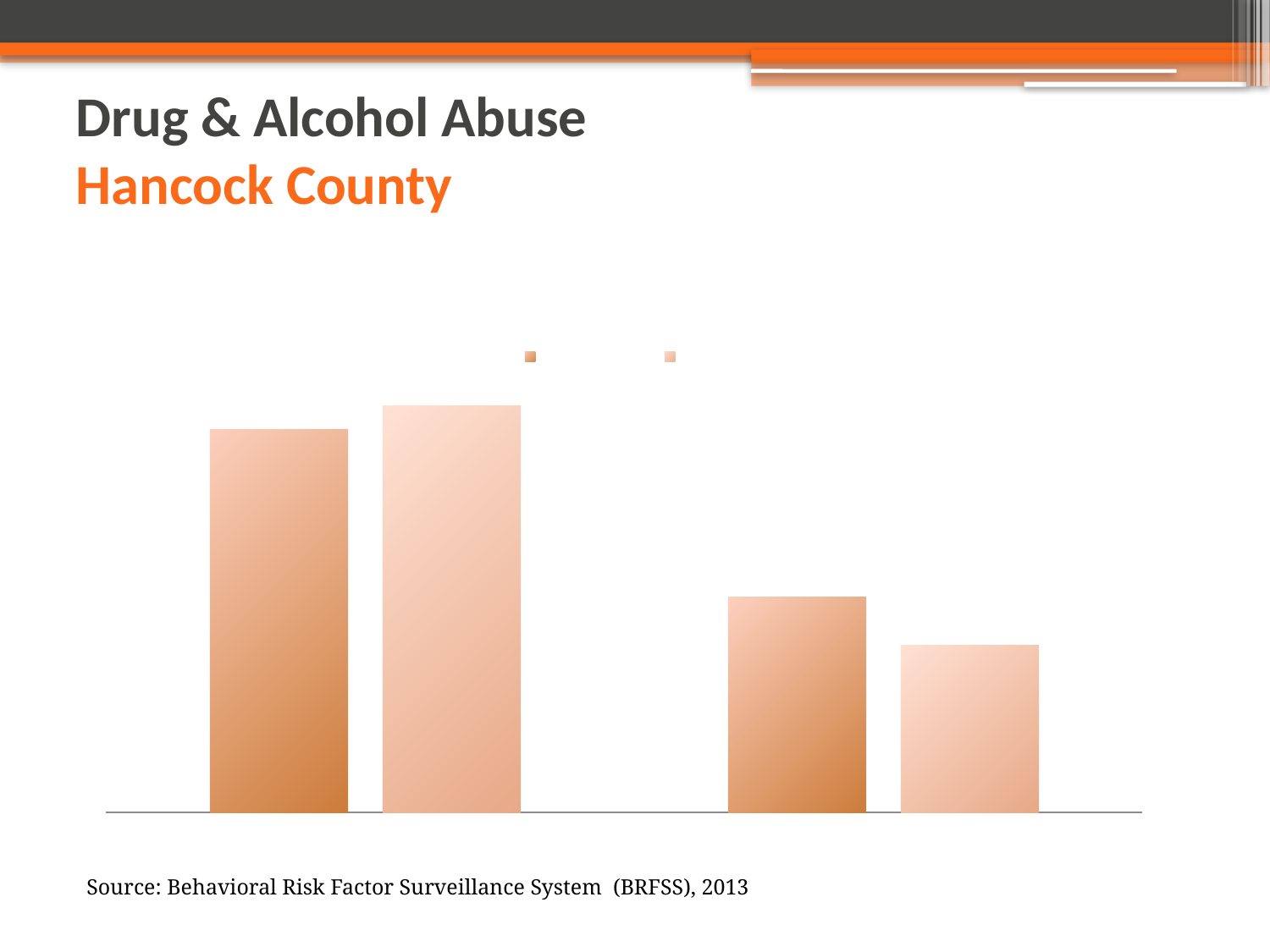
What source is cited below the chart? Behavioral Risk Factor Surveillance System (BRFSS), 2013 What is the title text shown above the chart on the slide? Drug & Alcohol Abuse Hancock County Which bar is the tallest in the chart, counting from the left? the second bar Is the leftmost bar taller or shorter than the rightmost bar? taller Which bar is the shortest in the chart, counting from the left? the fourth (rightmost) bar What kind of chart is shown on the slide? bar chart How many series does the chart's legend list? 2 How many groups of bars (categories) does the chart show? 2 How many bars are plotted in the chart? 4 Are the bars in the left group taller or shorter than the bars in the right group? taller